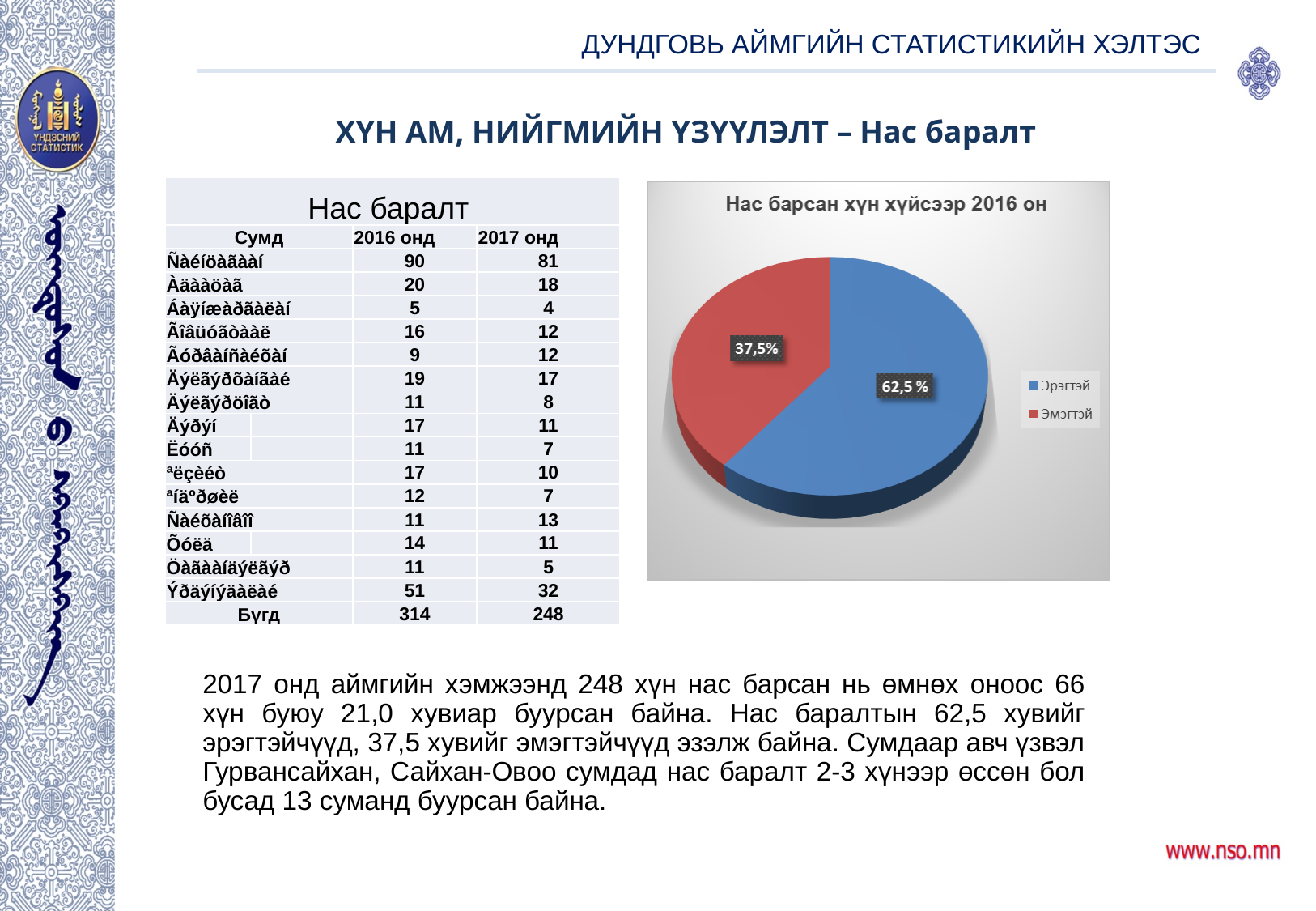
Which slice of the pie chart is the smallest? Эмэгтэй What is the title of the pie chart? Нас барсан хүн хүйсээр 2016 он Which slice of the pie chart is the largest? Эрэгтэй How many slices does the pie chart have? 2 Which is larger in the pie chart, Эрэгтэй or Эмэгтэй? Эрэгтэй What share of the pie chart does the Эрэгтэй slice represent? 62,5 % Is the share of the Эмэгтэй slice greater or less than 50%? less How many entries does the legend of the pie chart list? 2 By how many percentage points does the Эрэгтэй slice exceed the Эмэгтэй slice? 25 percentage points What share of the pie chart does the Эмэгтэй slice represent? 37,5% What kind of chart is shown on the slide? Pie chart What colour is the Эрэгтэй slice in the pie chart? Blue